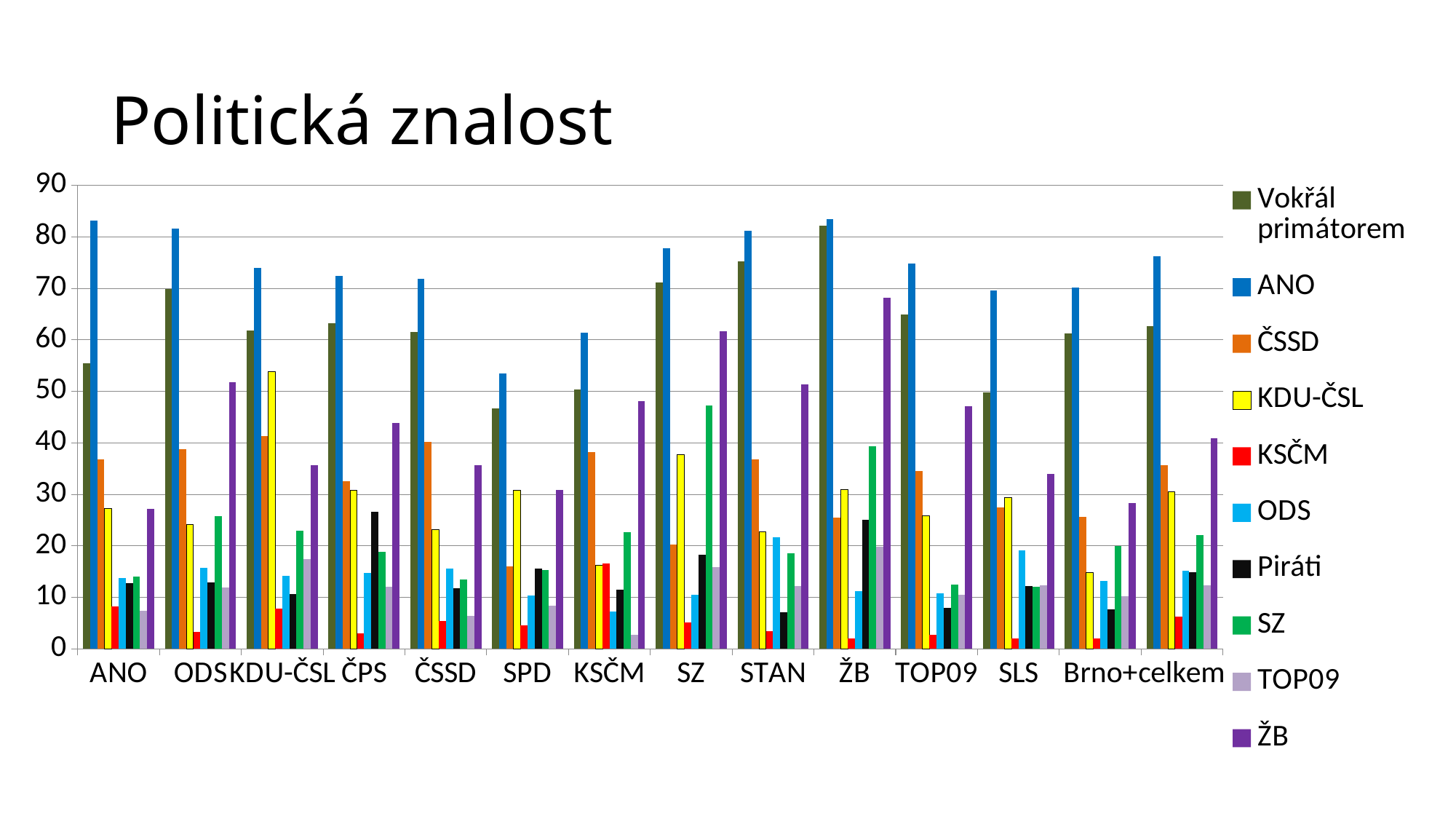
Is the value of the Piráti series for the ČPS category greater or less than 20? greater Is the value of the KSČM series for the ANO category greater or less than 10? less Is the value of the ANO series for the ANO category greater or less than 80? greater How many series does the legend list? 10 What is the title of the chart? Politická znalost How many categories are shown on the x axis? 14 What kind of chart is shown on the slide? bar chart What colour represents the ANO series in the legend? blue Which category has the lowest value for the ANO series? SPD For the ANO category, which is larger: the ANO series or the Vokřál primátorem series? ANO